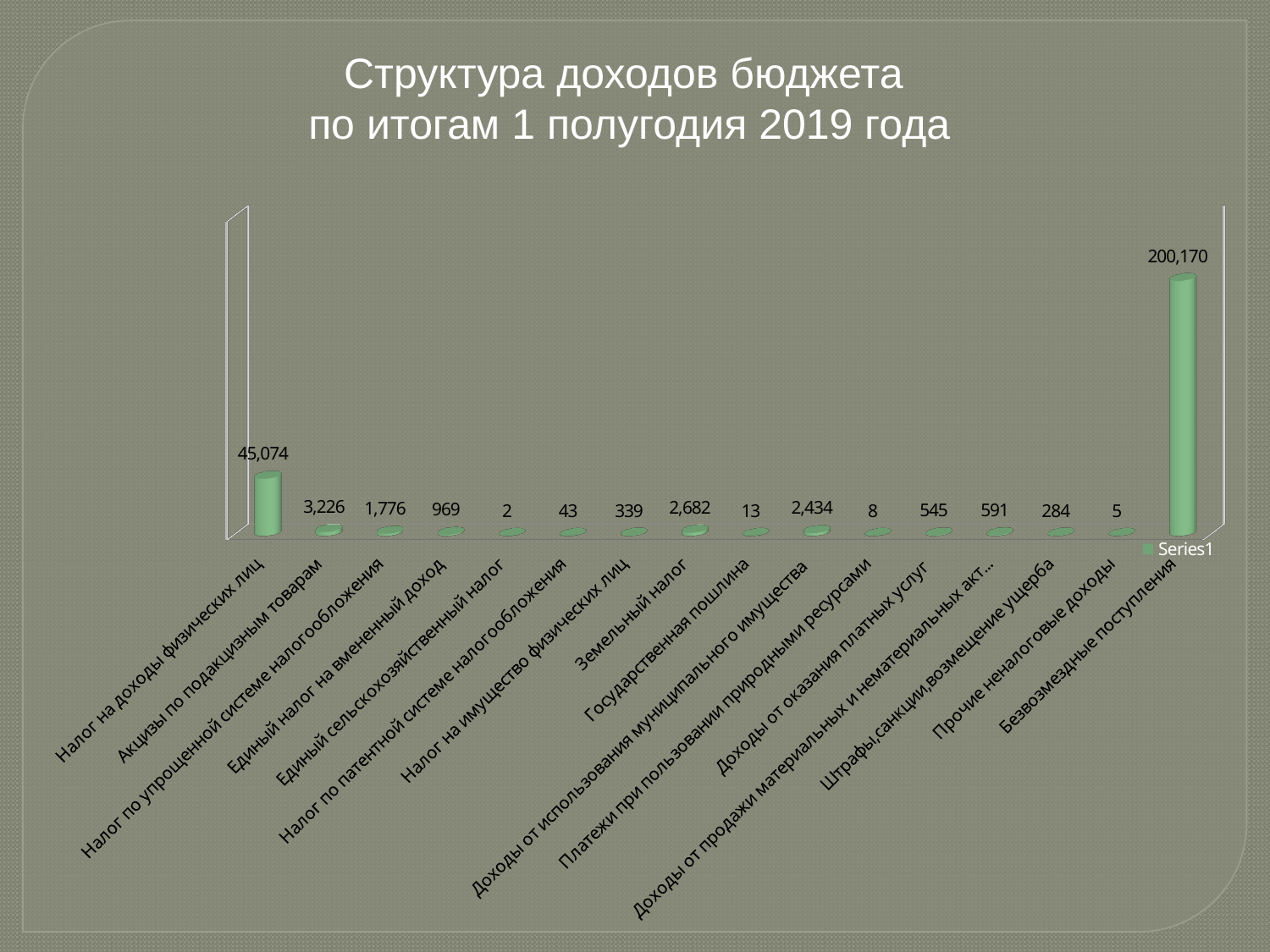
What is the value for Земельный налог? 2,682 What is the value for Налог на доходы физических лиц? 45,074 What kind of chart is shown on the slide? Bar chart What is the difference between the values for Безвозмездные поступления and Налог на доходы физических лиц? 155,096 Which category has the highest value? Безвозмездные поступления Which category has the lowest value? Единый сельскохозяйственный налог How many categories are shown in the chart? 16 Which is larger: the value for Акцизы по подакцизным товарам or the value for Земельный налог? Акцизы по подакцизным товарам What is the title of the chart? Структура доходов бюджета по итогам 1 полугодия 2019 года What is the value for Безвозмездные поступления? 200,170 What is the value for Штрафы,санкции,возмещение ущерба? 284 How many series does the legend list? 1